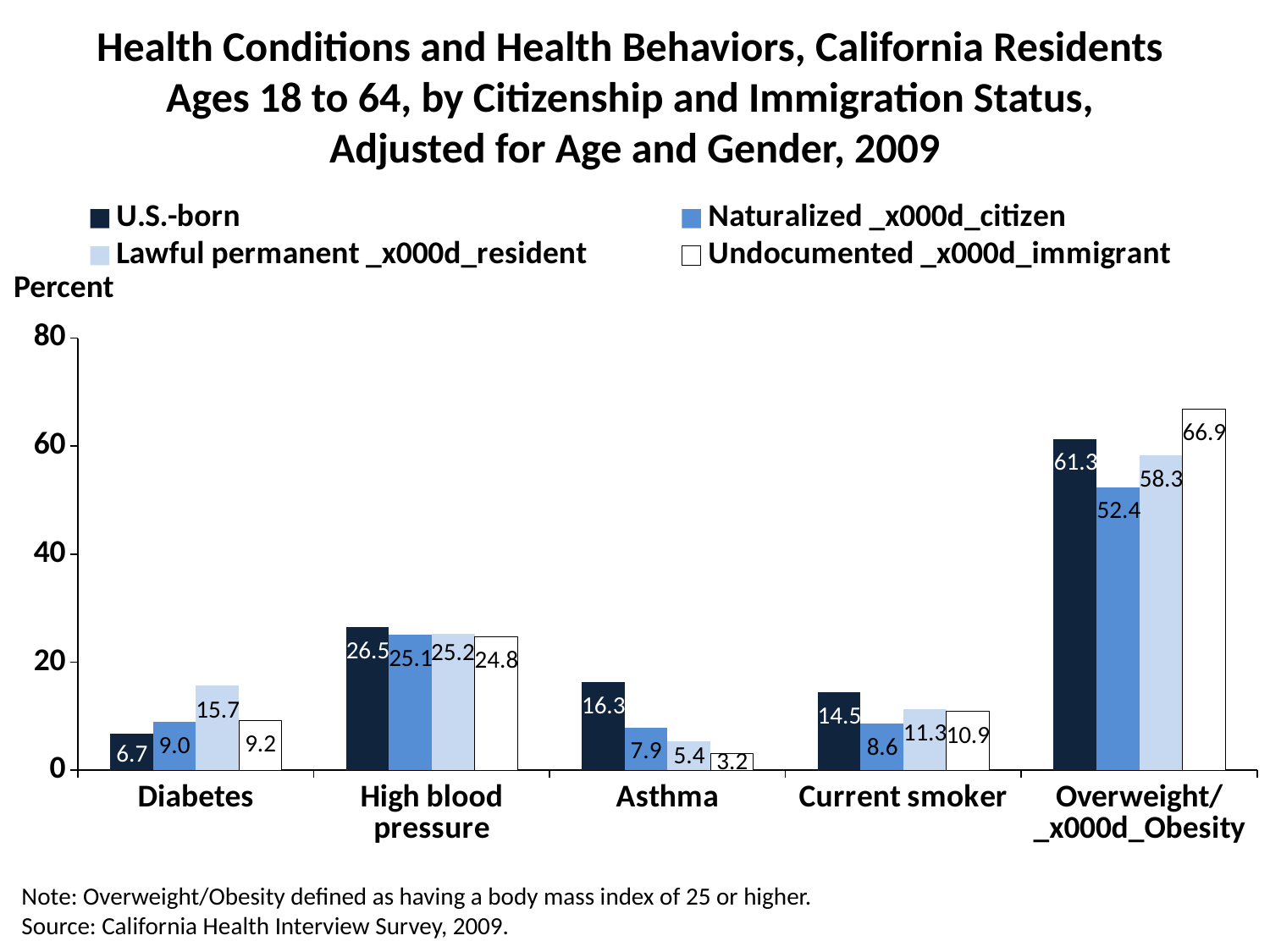
What is the label of the vertical axis? Percent What is the value for lawful permanent residents in the Current smoker category? 11.3 How many series does the legend list? 4 What kind of chart is shown on the slide? Bar chart Which group has the lowest value in the Overweight/Obesity category? Naturalized citizen What is the value for U.S.-born residents in the Diabetes category? 6.7 Which group has the highest value in the Asthma category? U.S.-born What is the value for naturalized citizens in the Asthma category? 7.9 What is the difference between the undocumented immigrant and U.S.-born values in the Overweight/Obesity category? 5.6 How many health condition or behavior categories are shown on the x axis? 5 Which is larger in the Diabetes category: the value for lawful permanent residents or the value for undocumented immigrants? Lawful permanent resident What is the value for undocumented immigrants in the Overweight/Obesity category? 66.9